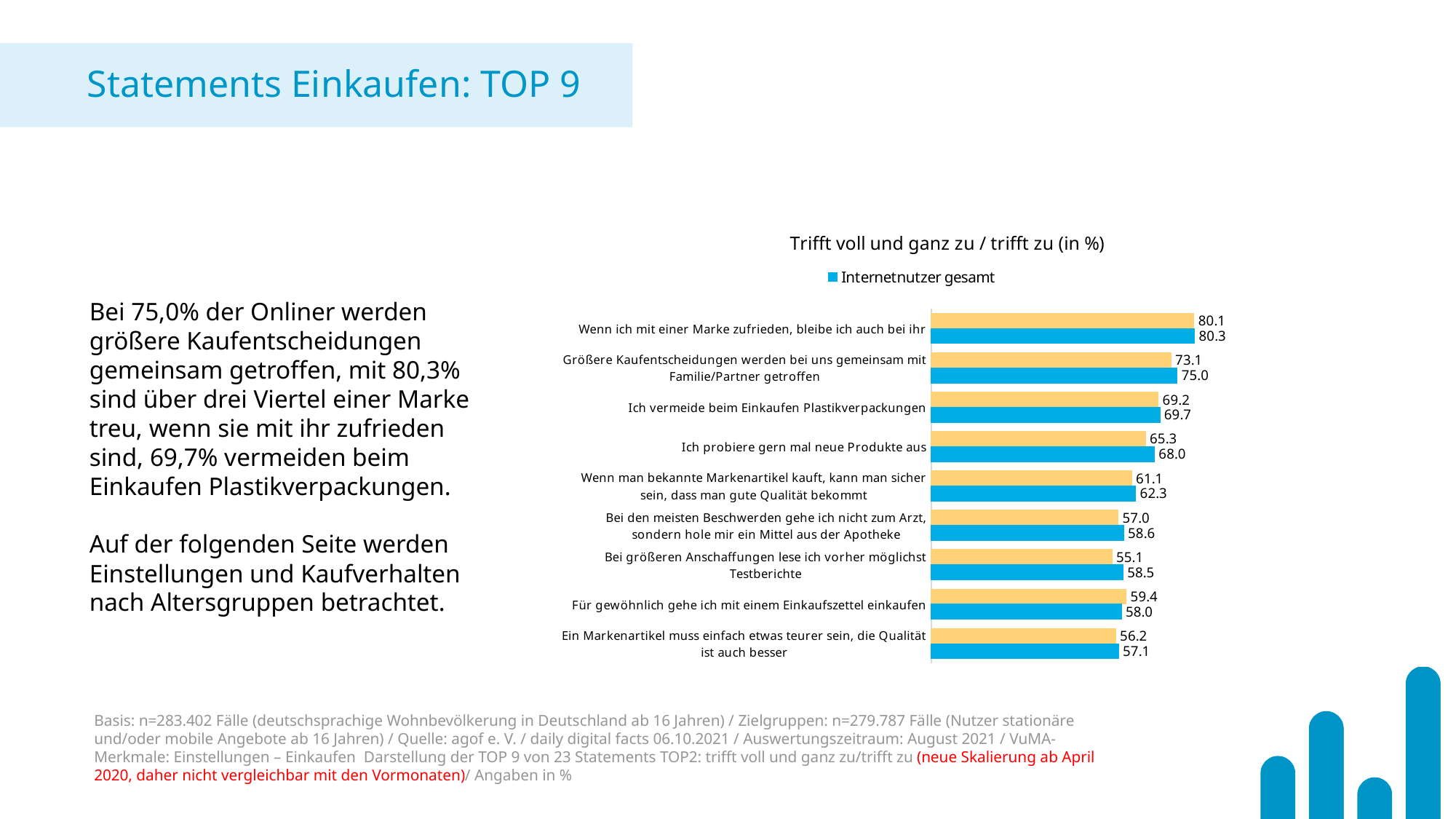
What kind of chart is shown on the slide? bar chart What is the difference between the Internetnutzer gesamt values for "Wenn ich mit einer Marke zufrieden, bleibe ich auch bei ihr" and "Größere Kaufentscheidungen werden bei uns gemeinsam mit Familie/Partner getroffen"? 5.3 Which statement has the lowest Internetnutzer gesamt value? Ein Markenartikel muss einfach etwas teurer sein, die Qualität ist auch besser What is the Internetnutzer gesamt value for "Ich vermeide beim Einkaufen Plastikverpackungen"? 69.7 How many statements (categories) are shown in the chart? 9 How many entries does the chart legend list? 1 What is the Internetnutzer gesamt value for "Ich probiere gern mal neue Produkte aus"? 68.0 Which statement has the highest Internetnutzer gesamt value? Wenn ich mit einer Marke zufrieden, bleibe ich auch bei ihr What is the title of the chart? Trifft voll und ganz zu / trifft zu (in %) For "Für gewöhnlich gehe ich mit einem Einkaufszettel einkaufen", which bar is larger: the yellow bar or the blue Internetnutzer gesamt bar? the yellow bar What is the value of the yellow bar for "Für gewöhnlich gehe ich mit einem Einkaufszettel einkaufen"? 59.4 Do the Internetnutzer gesamt values decrease from the top statement to the bottom statement? yes